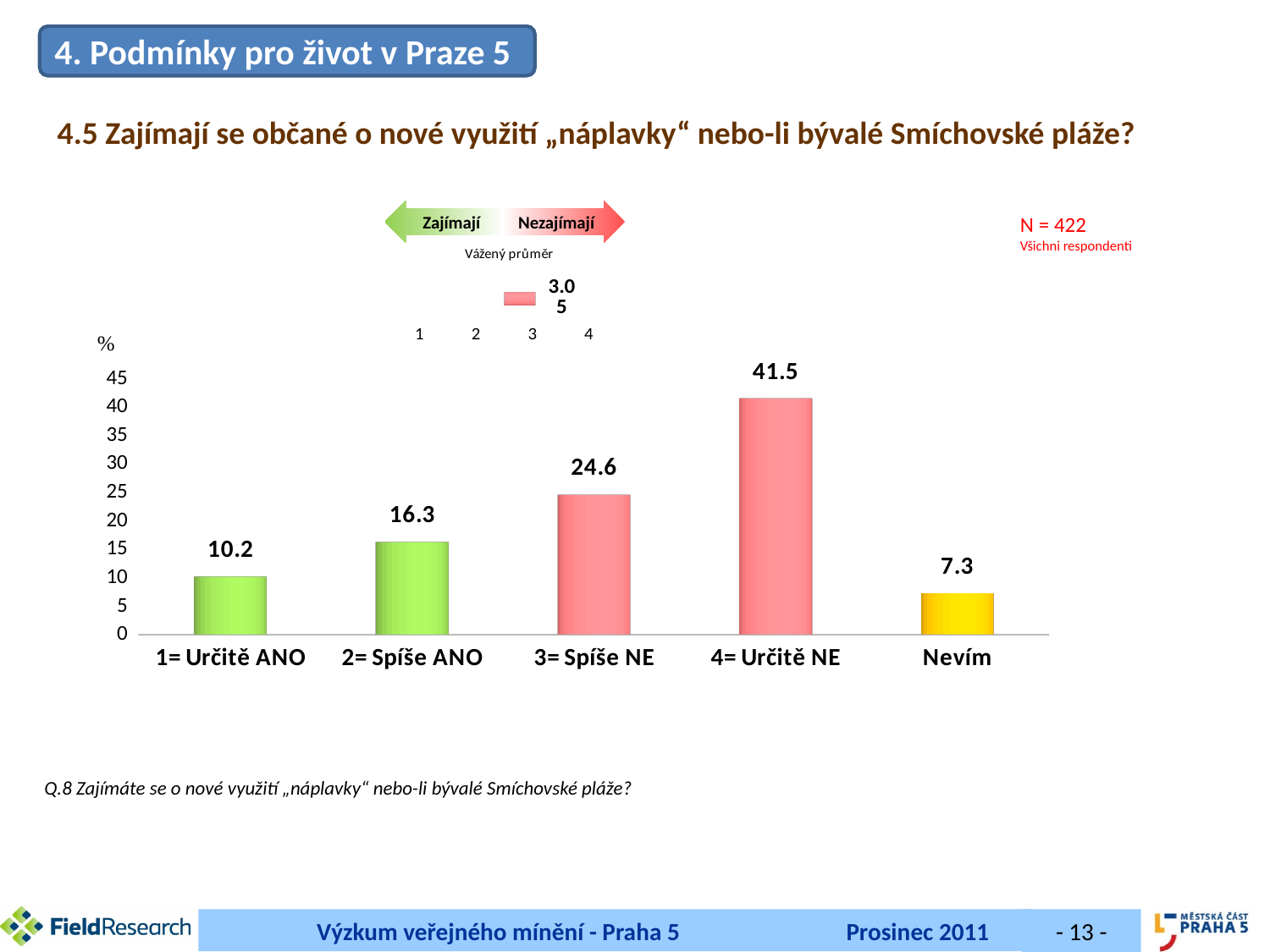
What is the difference between the values for "4= Určitě NE" and "3= Spíše NE"? 16.9 Which is larger, the value for "2= Spíše ANO" or the value for "3= Spíše NE"? 3= Spíše NE Is the value for "3= Spíše NE" greater or less than 20? greater Which category has the highest value in the bar chart? 4= Určitě NE Which category has the lowest value in the bar chart? Nevím How many categories are shown on the x axis of the bar chart? 5 What is the value for "Nevím" in the bar chart? 7.3 What kind of chart is used to show the percentages by category? bar chart What is the number of respondents (N) stated on the slide? 422 What is the value for "1= Určitě ANO" in the bar chart? 10.2 What is the value for "2= Spíše ANO" in the bar chart? 16.3 What is the value for "4= Určitě NE" in the bar chart? 41.5